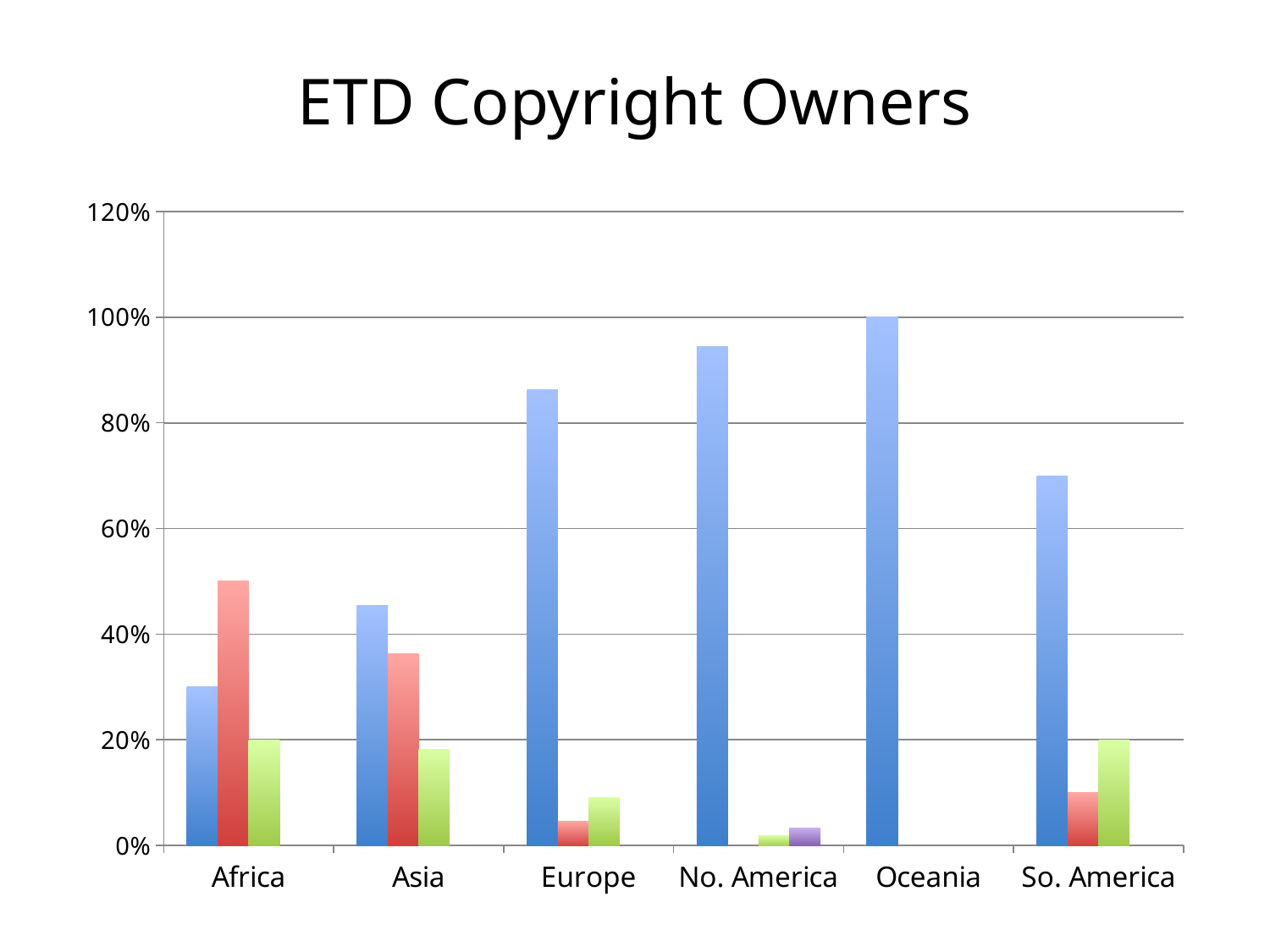
Which region is the only one with a purple bar? No. America Is the red bar for Africa greater or less than 40%? greater What is the value of the blue bar for Oceania? 100% Is the blue bar for Asia greater or less than 60%? less What kind of chart is shown on the slide? bar chart What is the title of the chart? ETD Copyright Owners Which region has the lowest blue bar? Africa What is the value of the green bar for Africa? 20% Which is larger for Africa, the blue bar or the red bar? the red bar How many regions are shown on the x axis? 6 Is the blue bar for Europe greater or less than 80%? greater Which region has the highest blue bar? Oceania